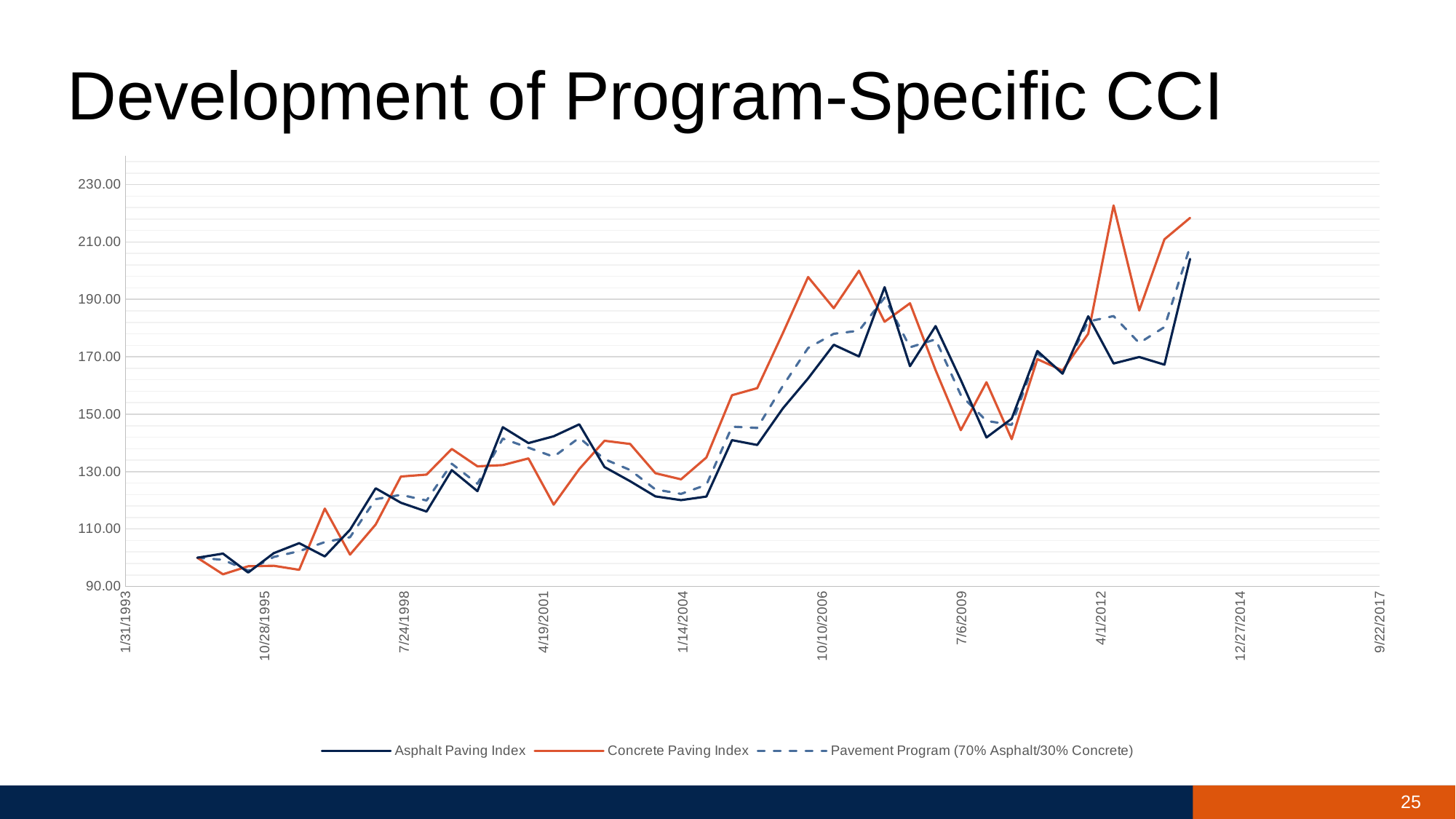
What is the title of the slide containing the chart? Development of Program-Specific CCI Which series is drawn with a dashed line? Pavement Program (70% Asphalt/30% Concrete) Near 4/19/2001, which is higher: the Asphalt Paving Index or the Concrete Paving Index? Asphalt Paving Index Overall, do the index values rise or fall from 1993 to 2014 along the x axis? rise Near 4/1/2012, which is higher: the Concrete Paving Index or the Asphalt Paving Index? Concrete Paving Index What kind of chart is shown on the slide? line chart Which series reaches the highest value anywhere on the chart? Concrete Paving Index How many series does the legend list? 3 Is the value of the Asphalt Paving Index near 1/14/2004 greater or less than 130? less How many date labels are shown on the x axis? 10 Is the value of the Concrete Paving Index at 7/6/2009 greater or less than 150? less Is the peak value of the Concrete Paving Index near 4/1/2012 greater or less than 210? greater